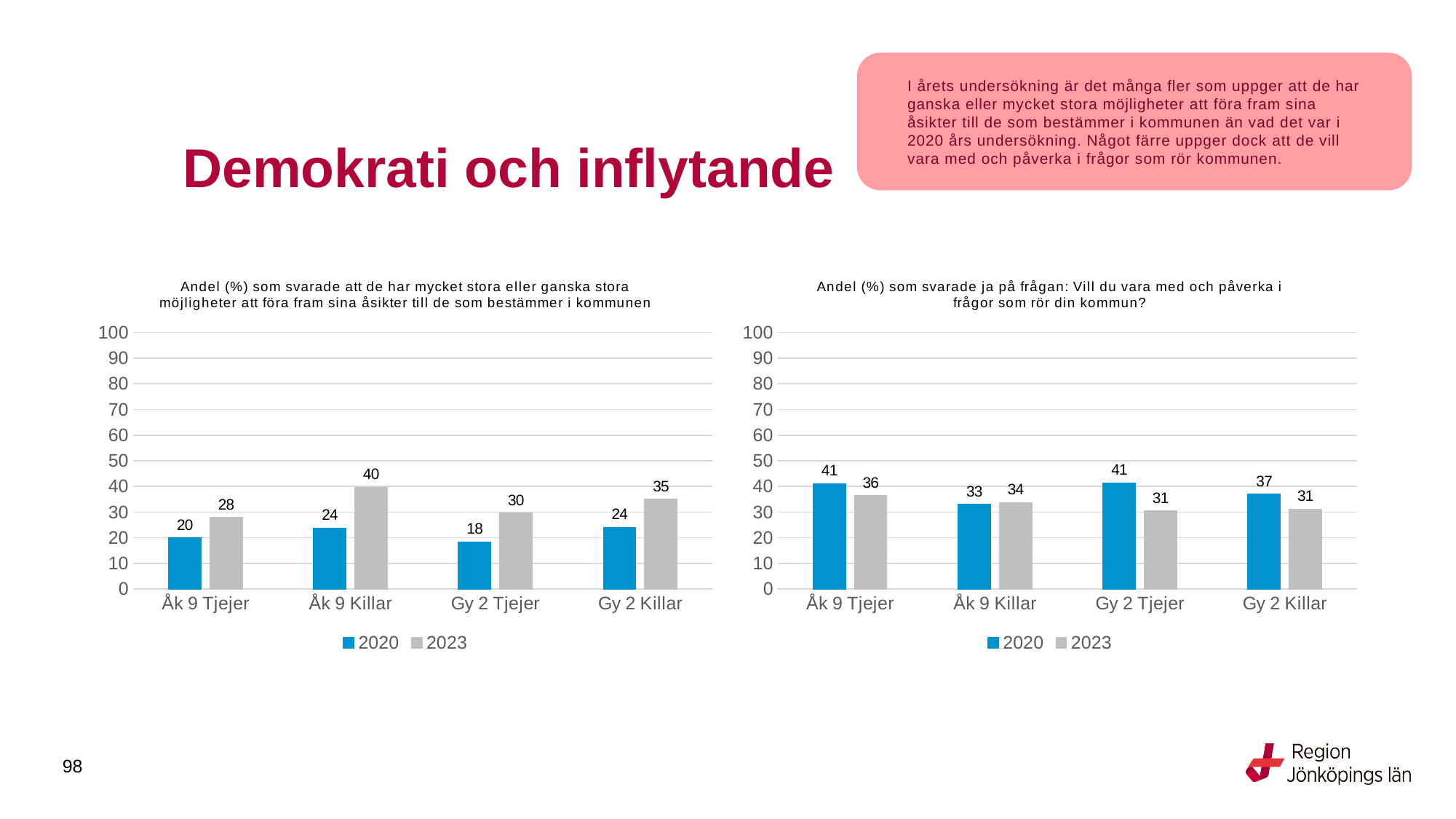
What kind of chart is the left chart (möjligheter att föra fram sina åsikter)? bar chart In the left chart (möjligheter att föra fram sina åsikter), what is the 2023 value for Åk 9 Killar? 40 In the left chart (möjligheter att föra fram sina åsikter), which category has the lowest 2020 value? Gy 2 Tjejer In the right chart (Vill du vara med och påverka), what is the 2023 value for Åk 9 Tjejer? 36 How many categories are shown on the x axis of the left chart? 4 In the right chart (Vill du vara med och påverka), is the 2020 value for Gy 2 Killar larger or smaller than the 2023 value? larger In the left chart (möjligheter att föra fram sina åsikter), is the 2023 value for Gy 2 Killar greater or less than 30? greater In the right chart (Vill du vara med och påverka), which category has the highest 2020 value? Åk 9 Tjejer and Gy 2 Tjejer (both 41) In the right chart (Vill du vara med och påverka), what is the difference between the 2020 and 2023 values for Gy 2 Tjejer? 10 In the left chart (möjligheter att föra fram sina åsikter), what is the difference between the 2023 and 2020 values for Åk 9 Killar? 16 In the left chart (möjligheter att föra fram sina åsikter), what is the 2020 value for Gy 2 Tjejer? 18 How many series does the legend of the right chart list? 2